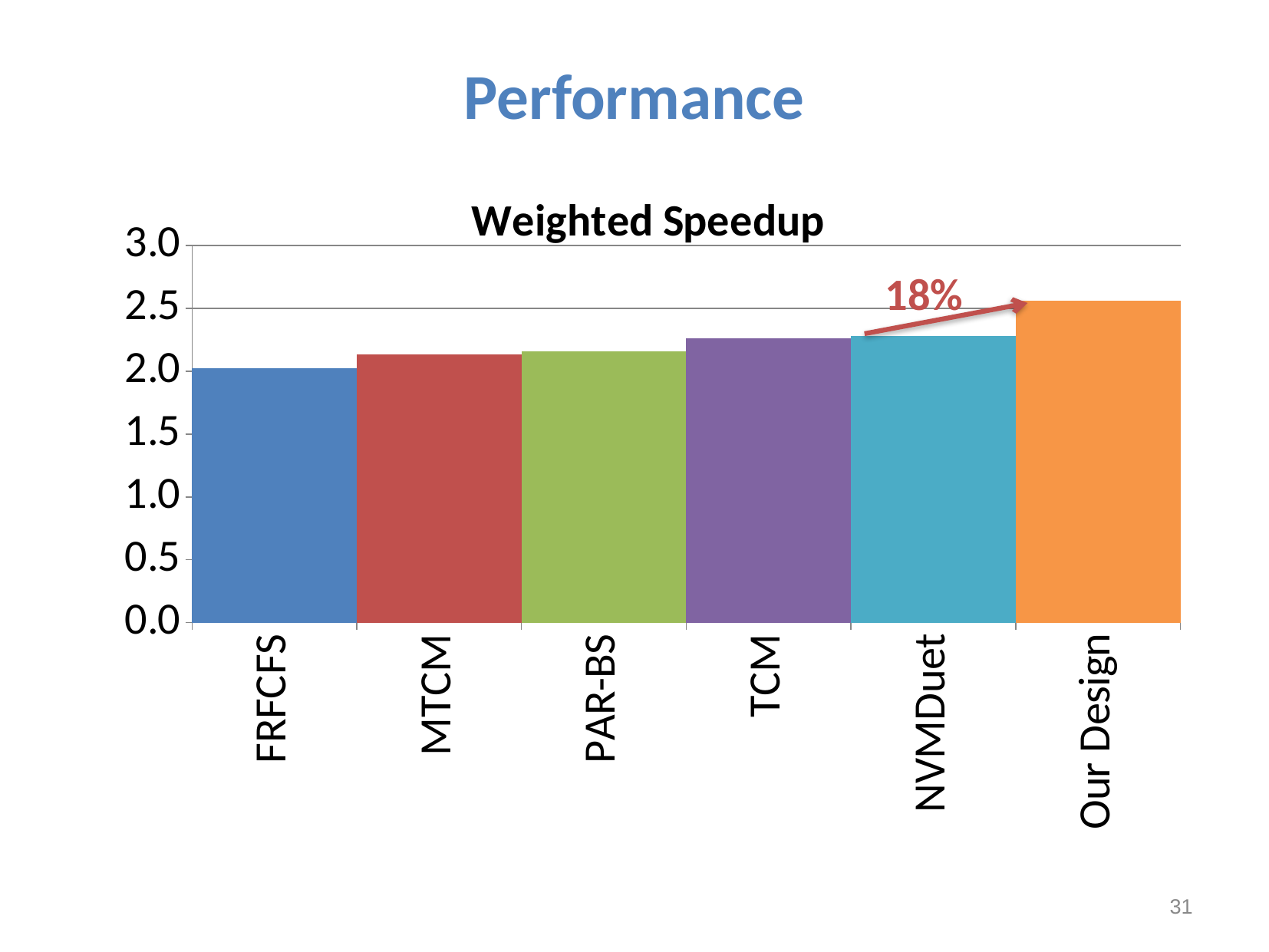
Is the weighted speedup for FRFCFS greater or less than 2.5? less Is the weighted speedup for Our Design greater or less than 2.5? greater How many categories (bars) are plotted in the Weighted Speedup chart? 6 Which category has the highest weighted speedup? Our Design Which has a higher weighted speedup, Our Design or NVMDuet? Our Design Is the weighted speedup for MTCM greater or less than 1.5? greater Do the weighted speedup values generally rise or fall from left to right across the categories? rise What percentage improvement is annotated between NVMDuet and Our Design? 18% What kind of chart is shown on the slide? bar chart Which category has the lowest weighted speedup? FRFCFS Which has a higher weighted speedup, TCM or MTCM? TCM